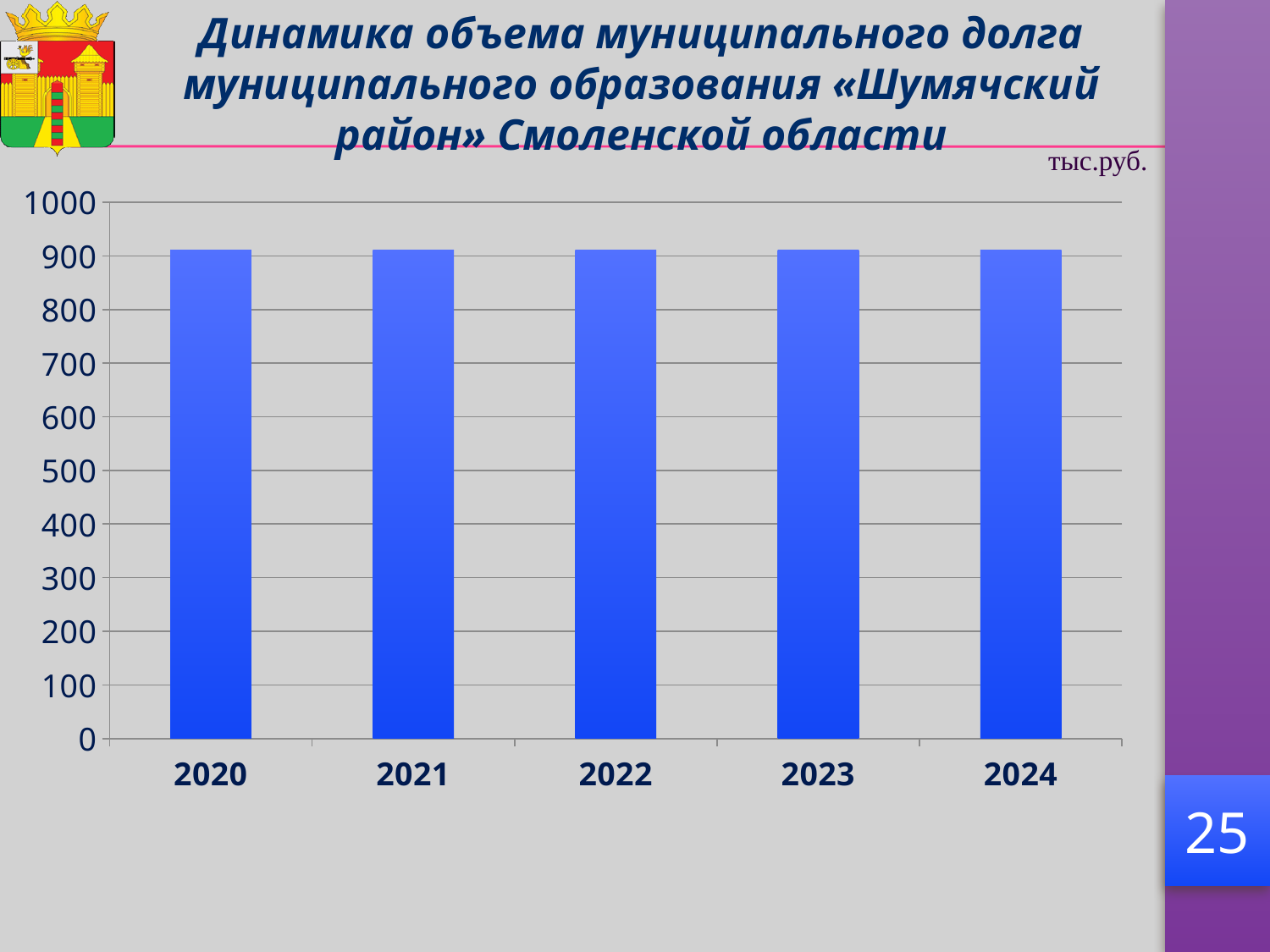
Is the value for 2020 greater or less than 800? greater What unit is indicated above the chart? тыс.руб. Do the values rise, fall, or stay the same from 2020 to 2024? stay the same How many years are shown on the x axis of the chart? 5 Is the value for 2021 greater or less than 700? greater Is the value for 2024 greater or less than 500? greater What kind of chart is shown on the slide? bar chart What is the first year shown on the x axis? 2020